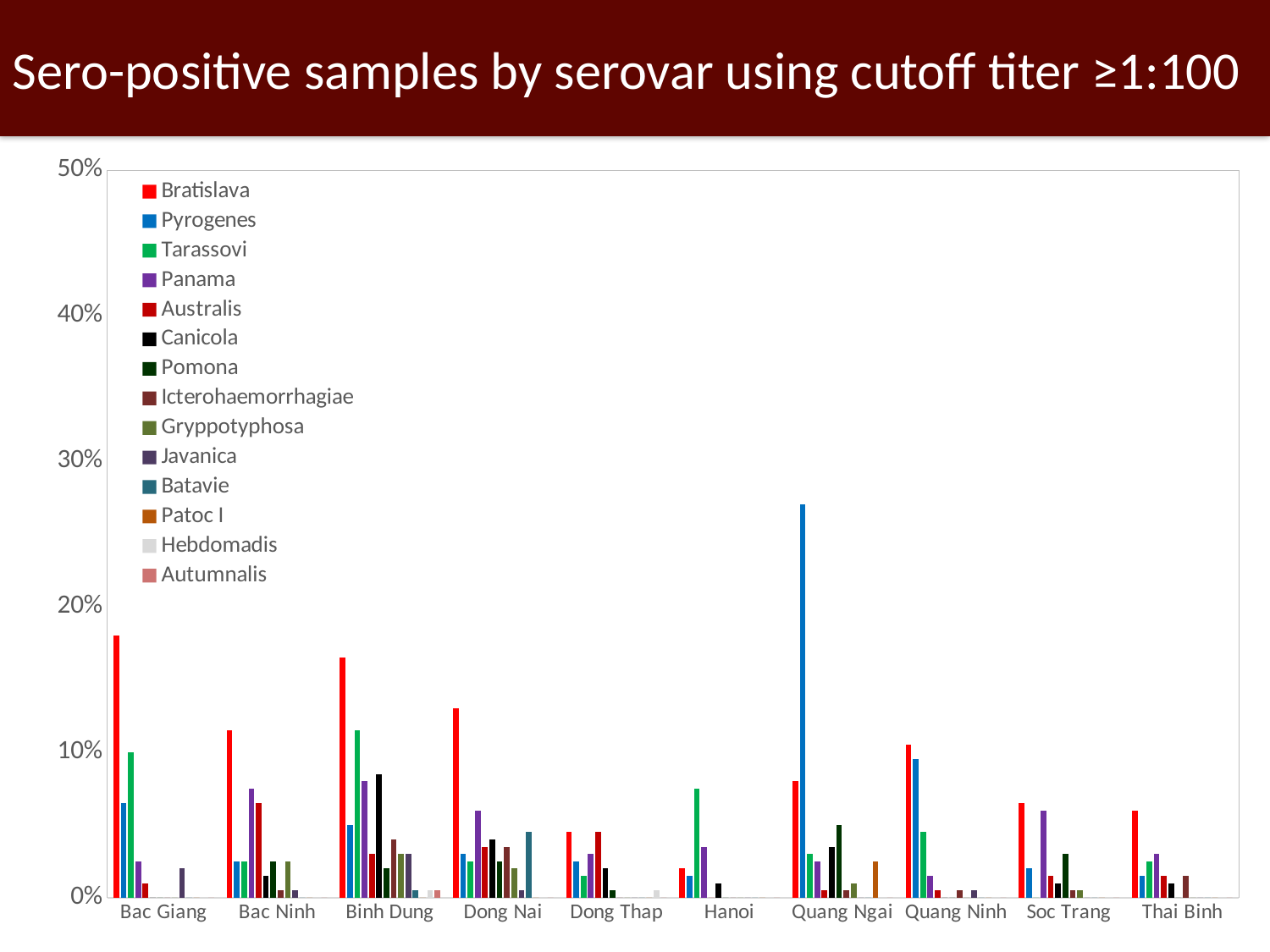
Is the value for Tarassovi in Hanoi greater or less than 10%? less Which is larger, the Bratislava value in Bac Giang or the Bratislava value in Bac Ninh? Bac Giang How many provinces are shown along the x axis? 10 Is the value for Bratislava in Bac Giang greater or less than 10%? greater Is the value for Bratislava in Dong Nai greater or less than 10%? greater Which province has the lowest Bratislava value? Hanoi Which serovar and province combination has the tallest bar in the chart? Pyrogenes in Quang Ngai How many serovars does the legend list? 14 What is the title of the chart? Sero-positive samples by serovar using cutoff titer ≥1:100 What kind of chart is shown on the slide? bar chart In Quang Ngai, which is larger, the Bratislava bar or the Pyrogenes bar? Pyrogenes